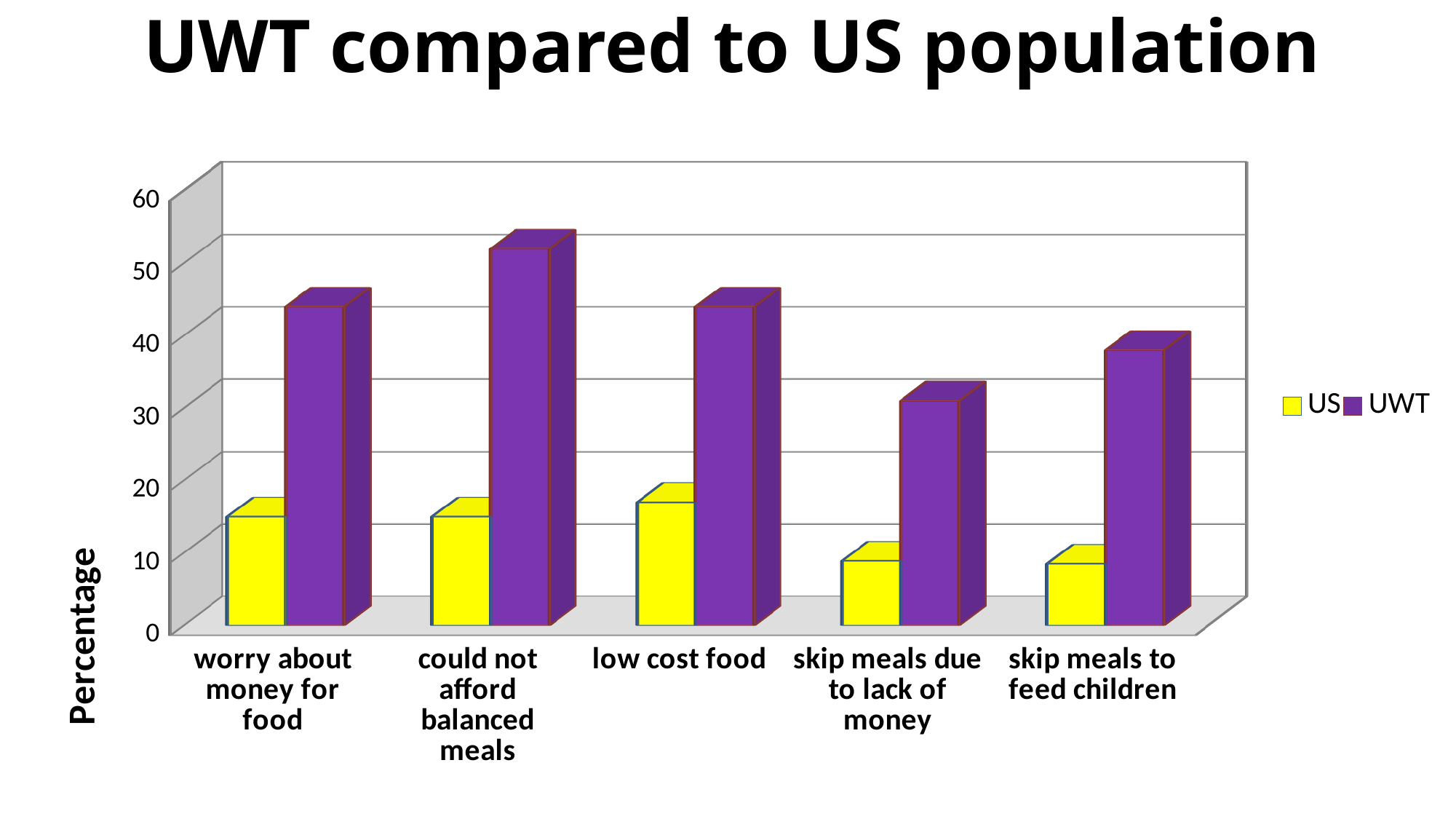
What kind of chart is shown on the slide? bar chart Is the US value for 'worry about money for food' greater or less than 20? less What is the label on the vertical axis? Percentage How many series does the legend list? 2 For 'low cost food', which is larger, the US value or the UWT value? UWT Which is larger, the UWT value for 'worry about money for food' or the UWT value for 'skip meals to feed children'? worry about money for food Is the UWT value for 'could not afford balanced meals' greater or less than 50? greater Is the UWT value for 'skip meals due to lack of money' greater or less than 40? less Which category has the highest UWT value? could not afford balanced meals Which category has the lowest UWT value? skip meals due to lack of money How many categories are shown on the x axis? 5